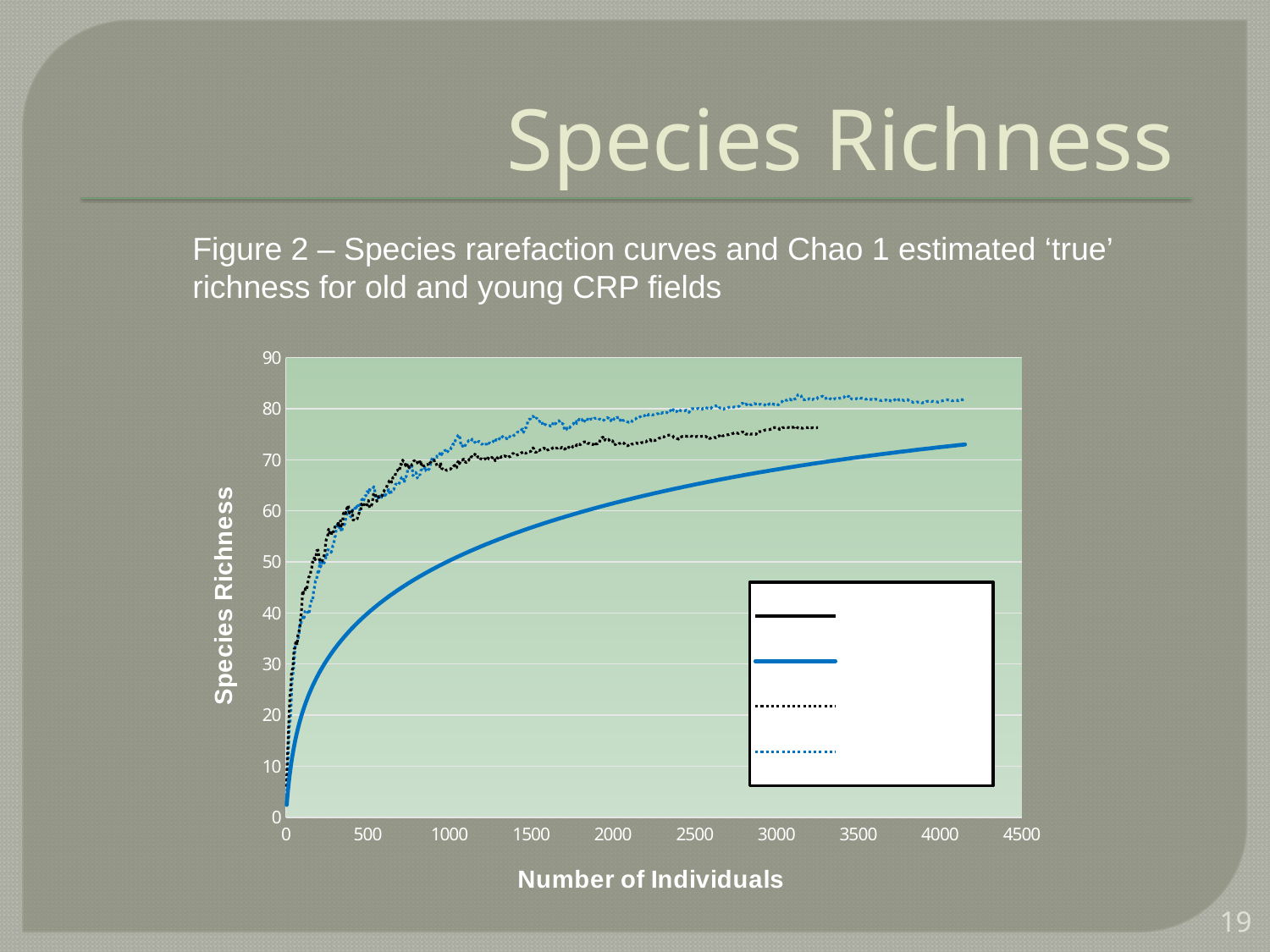
What is the title of the chart's y axis? Species Richness At 3000 individuals, which is higher: the dotted blue line or the dotted black line? dotted blue line What kind of chart is shown on the slide? line chart Is the value of the dotted blue line at 3000 individuals greater or less than 70? greater At 4000 individuals, which is higher: the solid blue line or the dotted blue line? dotted blue line What is the highest value shown on the chart's y axis? 90 Is the value of the dotted black line at 3000 individuals greater or less than 80? less Is the value of the solid blue line at 4000 individuals greater or less than 60? greater How many series does the chart's legend list? 4 Does the solid blue line rise or fall as the number of individuals increases? rise What is the title of the chart's x axis? Number of Individuals